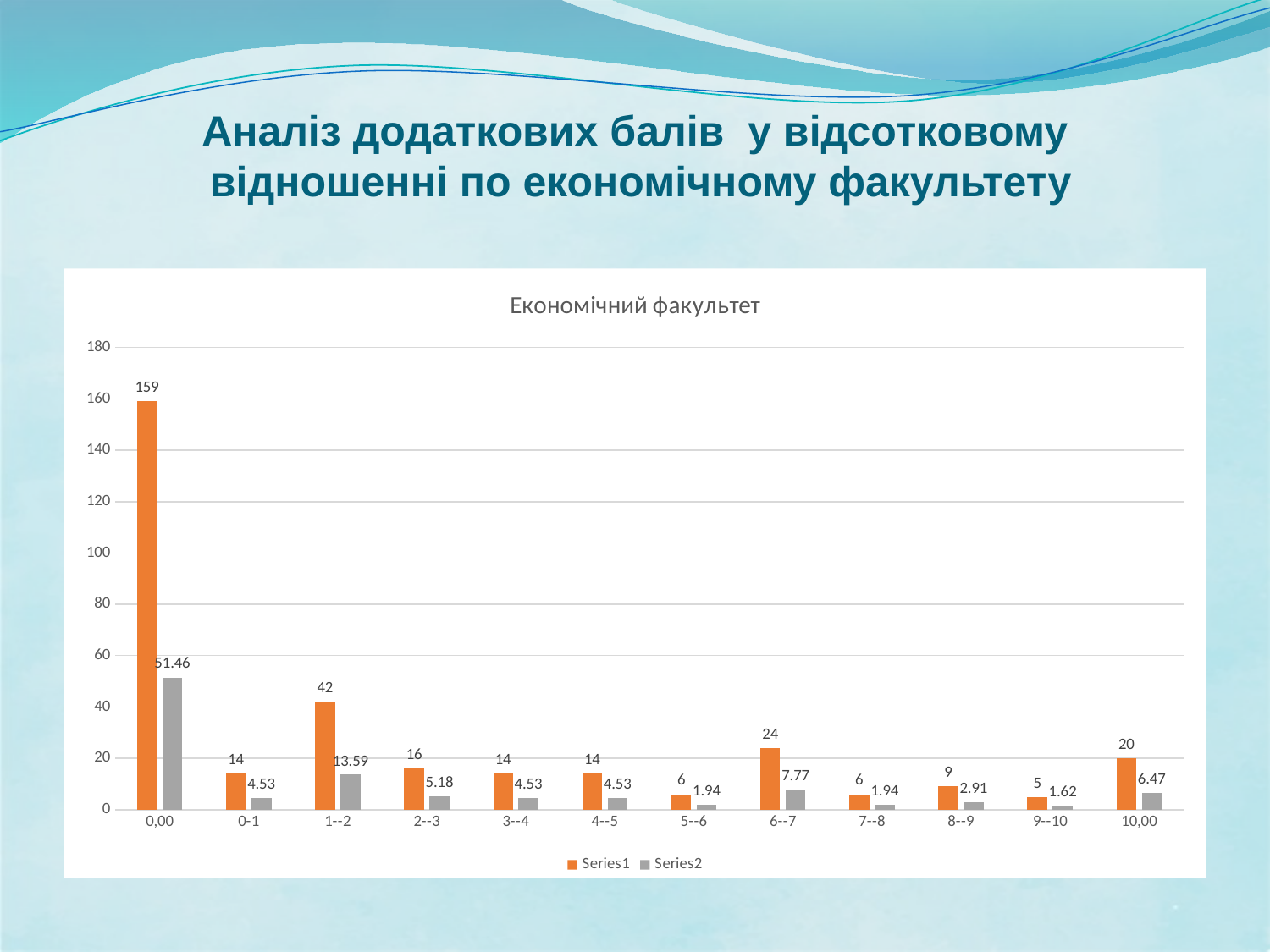
What is the Series1 value for the category 6--7? 24 How many series does the legend list? 2 What is the title of the chart? Економічний факультет How many categories are shown on the x axis? 12 Which category has the lowest Series2 value? 9--10 Which category has the highest Series1 value? 0,00 What is the difference between the Series1 values for 0,00 and 1--2? 117 What is the Series2 value for the category 1--2? 13.59 What kind of chart is shown on the slide? Bar chart Which is larger: the Series1 value for 6--7 or the Series1 value for 10,00? 6--7 What is the Series2 value for the category 10,00? 6.47 What is the Series1 value for the category 0,00? 159